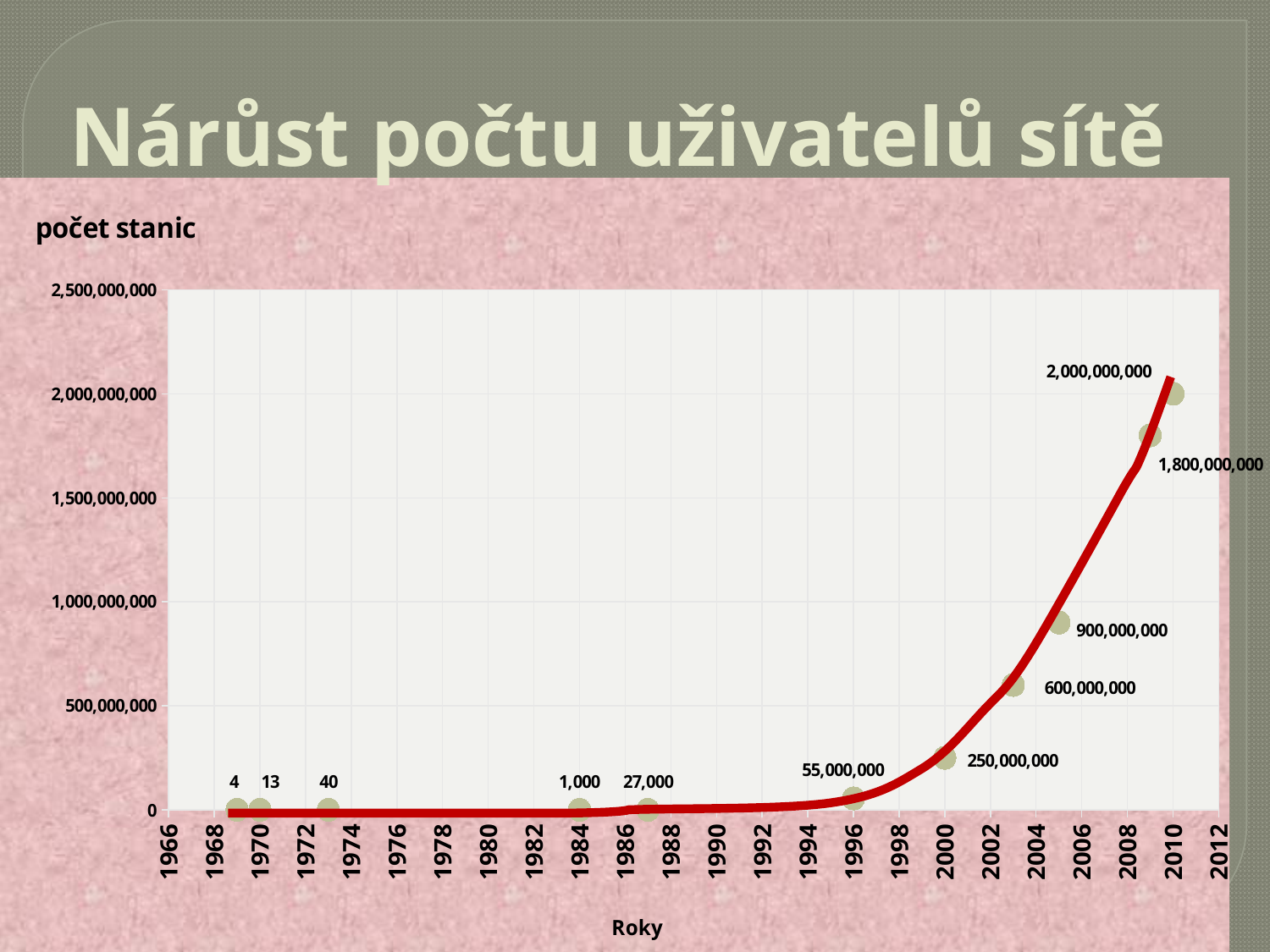
Which is larger: the point labelled 250,000,000 or the point labelled 55,000,000? 250,000,000 What is the value of the third data point from the left? 40 What is the lowest data label shown on the chart? 4 What is the difference between the two highest labelled values, 2,000,000,000 and 1,800,000,000? 200,000,000 What is the highest data label shown on the chart? 2,000,000,000 Do the values rise or fall as the years increase along the x axis? rise What is the difference between the points labelled 900,000,000 and 600,000,000? 300,000,000 What is the label of the x axis? Roky Is the value of the point labelled 900,000,000 greater or less than 1,000,000,000 on the y axis? less What is the difference between the points labelled 27,000 and 1,000? 26,000 What is the label of the y axis? počet stanic How many data points are plotted on the chart? 11